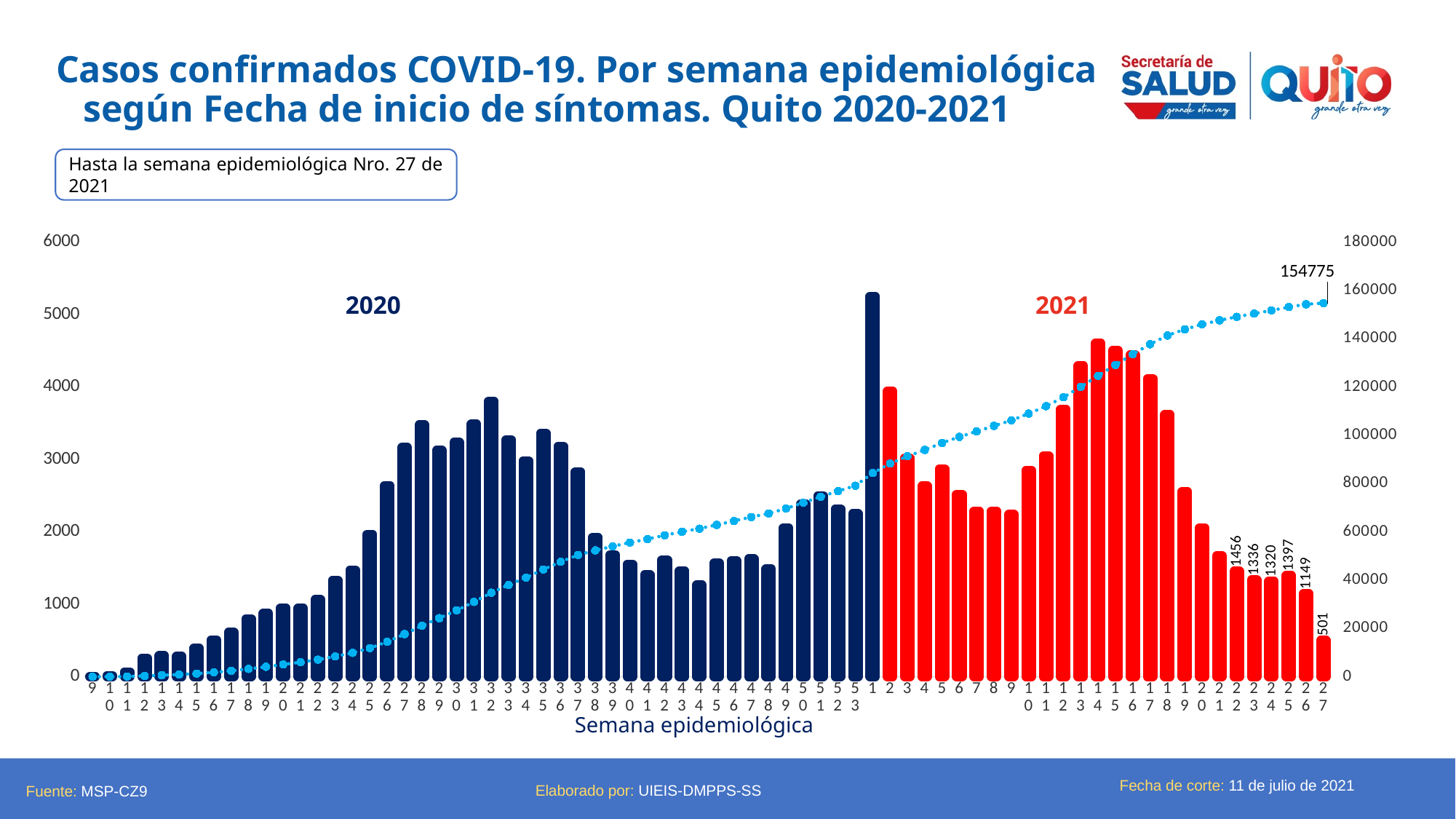
What value is labelled at the end of the dotted cumulative line at week 27 of 2021? 154775 What is the difference between the values for week 22 and week 27 of 2021? 955 What is the value of the bar for week 22 of 2021? 1456 Which week has the tallest bar on the chart? week 1 (of 2021) Is the value for week 32 of 2020 greater or less than 3000? greater What colour are the bars for 2021? red Does the dotted line rise or fall along the x axis? rises What is the value of the bar for week 27 of 2021? 501 Is the value for week 14 of 2021 greater or less than 4000? greater Is the value for week 18 of 2020 greater or less than 1000? less What is the difference between the values for week 25 and week 23 of 2021? 61 Which is larger, the value for week 24 or week 25 of 2021? week 25